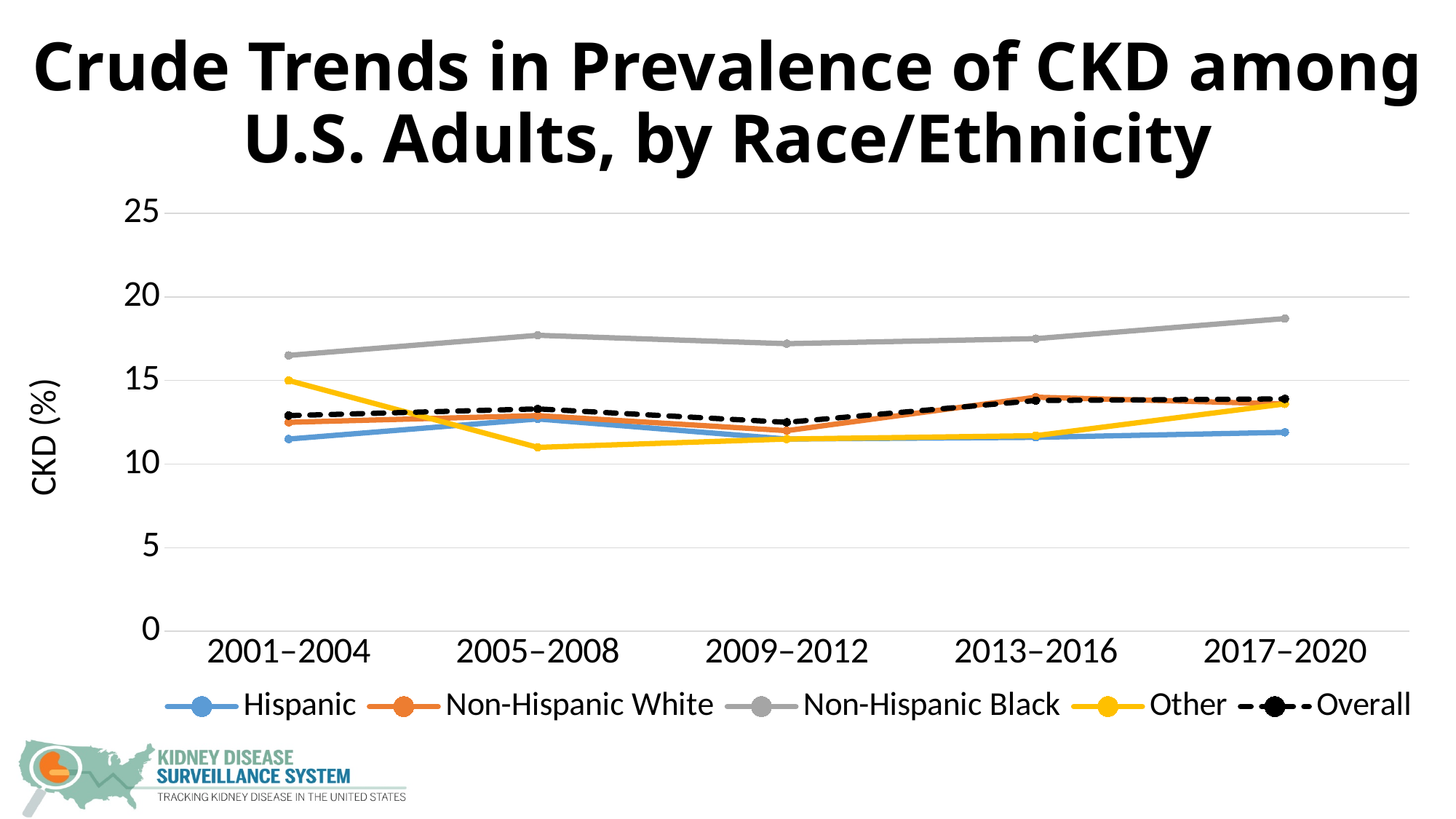
Does the value for Other rise or fall from 2001–2004 to 2005–2008? fall Which series is drawn with a dashed line? Overall Is the value for Non-Hispanic Black in 2001–2004 greater or less than 15? greater What kind of chart is shown on the slide? line chart Which race/ethnicity group has the highest CKD prevalence in 2017–2020? Non-Hispanic Black How many time periods are shown on the x axis? 5 In 2009–2012, which is larger: the value for Non-Hispanic Black or the value for Hispanic? Non-Hispanic Black Is the value for Hispanic in 2001–2004 greater or less than 15? less Is the value for Non-Hispanic Black in 2017–2020 greater or less than 20? less Which group has the lowest CKD prevalence in 2005–2008? Other What is the label on the y axis? CKD (%) How many series does the legend list? 5